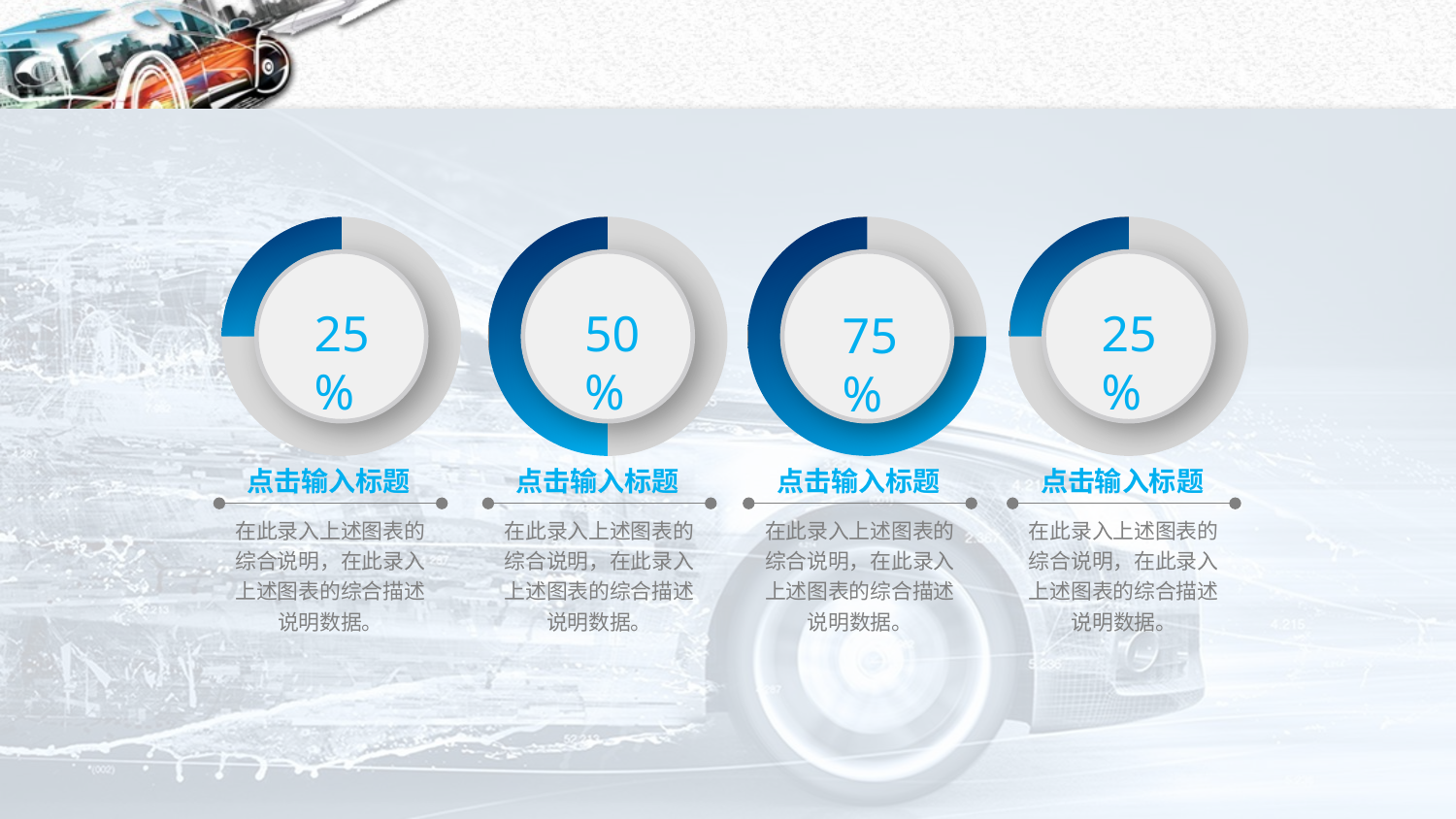
How many donut charts are on the slide? 4 What kind of chart is used to display the percentages on the slide? Donut chart Which donut chart shows the highest percentage? The third from the left (75%) What percentage is shown in the rightmost donut chart? 25% What is the difference between the percentage in the third donut chart and the percentage in the second donut chart? 25% What percentage is shown in the third donut chart from the left? 75% What colour is the filled portion of each donut chart? Blue What is the lowest percentage shown among the four donut charts? 25% What percentage is shown in the second donut chart from the left? 50% What percentage is shown in the leftmost donut chart? 25% Do the percentages in the first three donut charts increase or decrease from left to right? Increase Which is larger, the percentage in the second donut chart or the percentage in the leftmost donut chart? The second donut chart (50%)